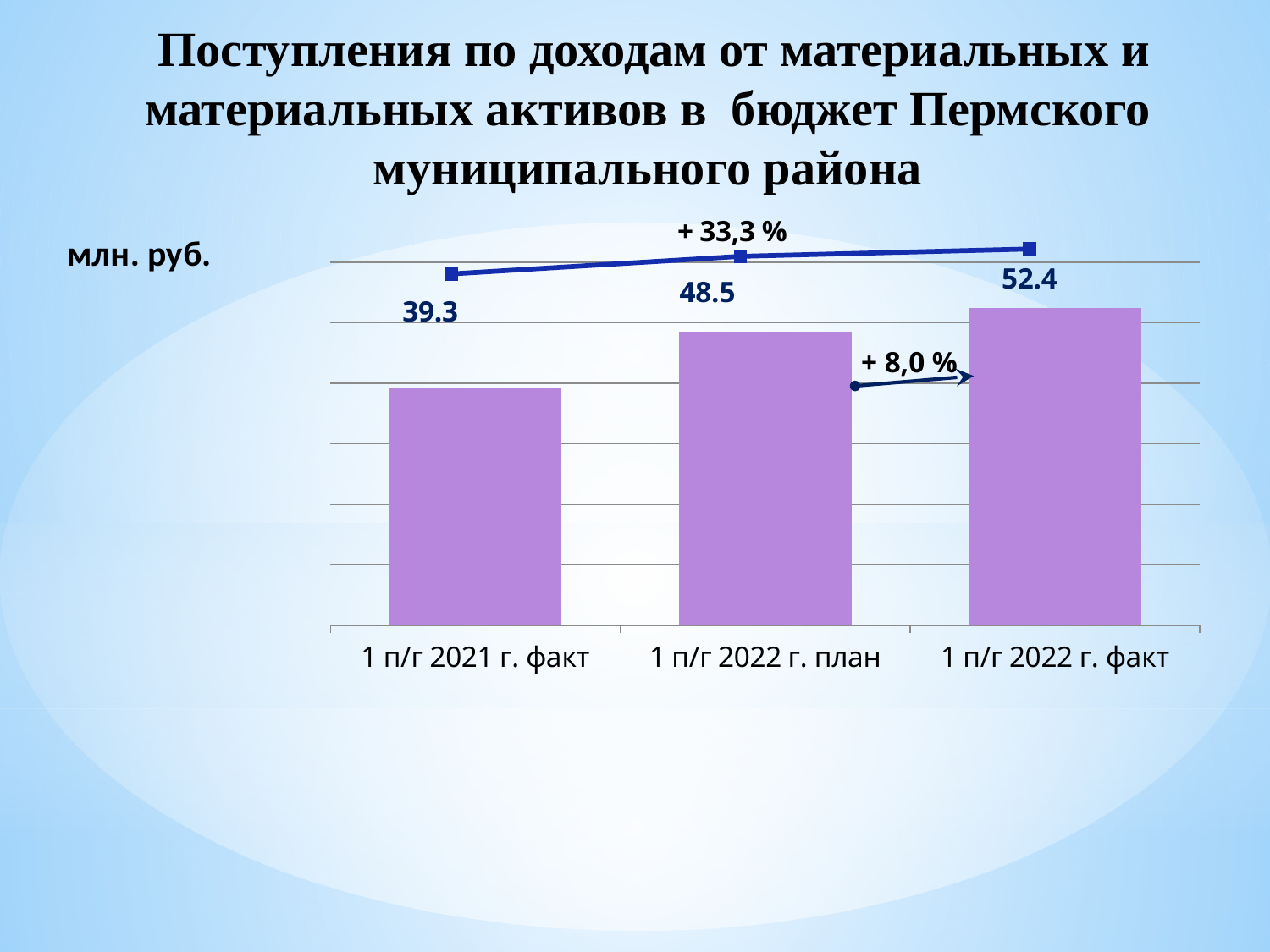
How many categories are shown on the x axis? 3 Which category has the lowest value? 1 п/г 2021 г. факт Do the values rise or fall from left to right along the x axis? rise What is the difference between the values for 1 п/г 2022 г. факт and 1 п/г 2022 г. план? 3.9 What kind of chart is this? bar chart with a line overlay Which category has the highest value? 1 п/г 2022 г. факт Which is larger, the value for 1 п/г 2022 г. план or the value for 1 п/г 2021 г. факт? 1 п/г 2022 г. план What is the value for 1 п/г 2021 г. факт? 39.3 What is the value for 1 п/г 2022 г. план? 48.5 What is the difference between the values for 1 п/г 2022 г. факт and 1 п/г 2021 г. факт? 13.1 What is the value for 1 п/г 2022 г. факт? 52.4 What unit of measurement is indicated next to the chart? млн. руб.